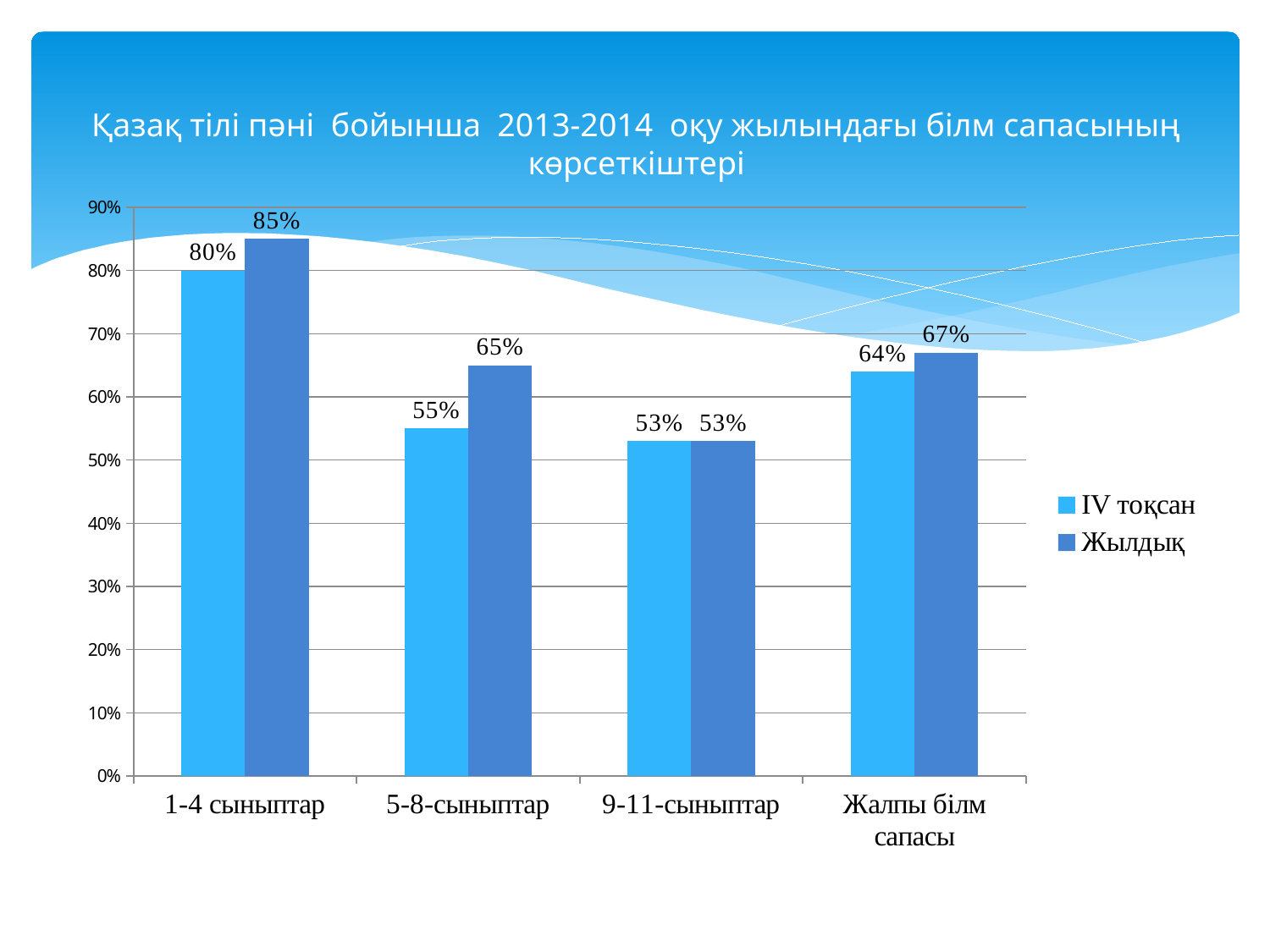
How many series does the legend list? 2 What is the difference between the Жылдық and IV тоқсан values for 5-8-сыныптар? 10% What is the Жылдық value for 5-8-сыныптар? 65% Which category has the lowest IV тоқсан value? 9-11-сыныптар Is the IV тоқсан value for Жалпы білм сапасы greater or less than 60%? greater What kind of chart is shown on the slide? bar chart What are the two series named in the legend? IV тоқсан and Жылдық Which is larger for 1-4 сыныптар: the IV тоқсан value or the Жылдық value? Жылдық How many categories are shown on the x axis? 4 Which category has the highest Жылдық value? 1-4 сыныптар What is the IV тоқсан value for 1-4 сыныптар? 80% What is the Жылдық value for Жалпы білм сапасы? 67%